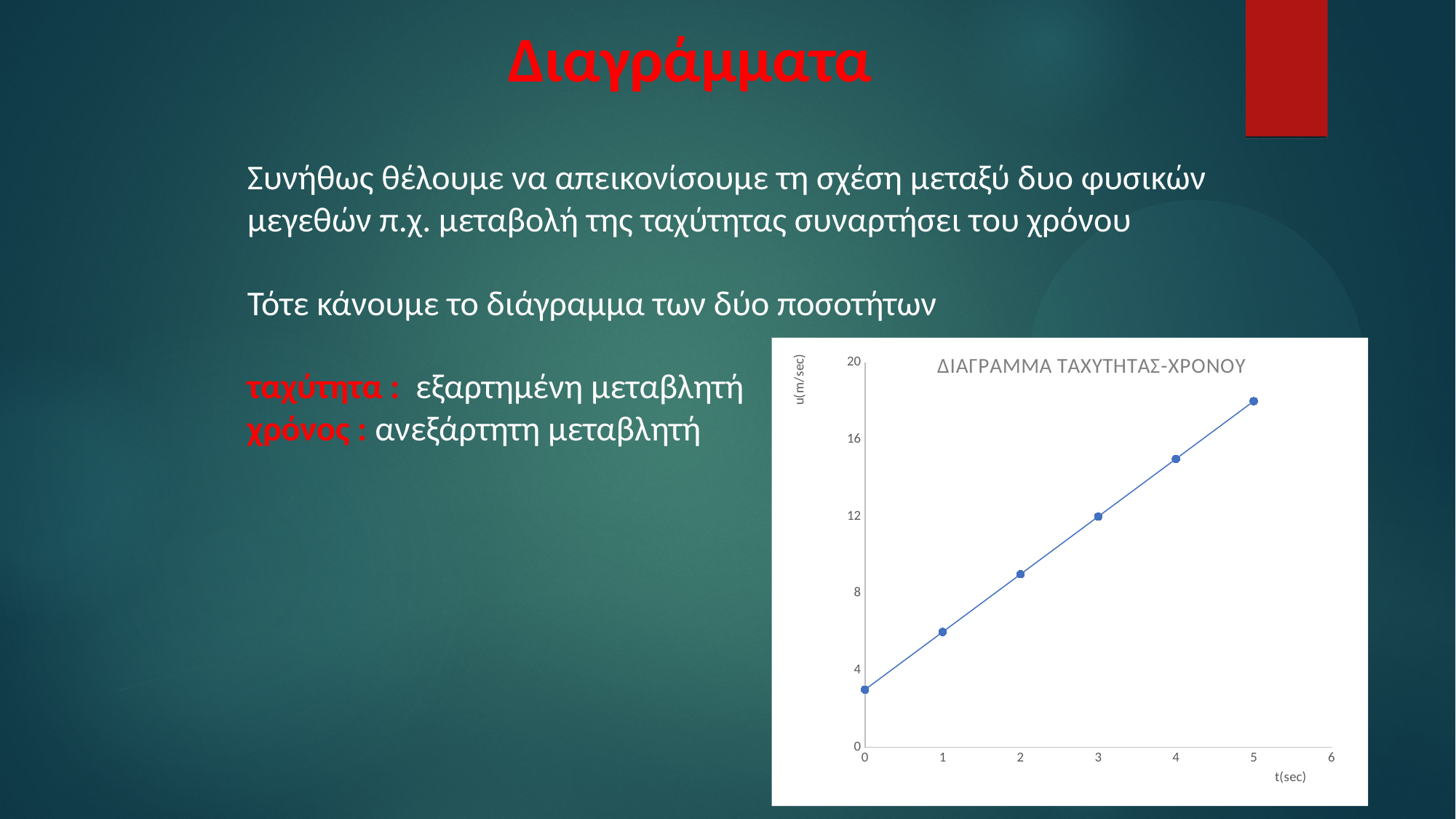
What is the title of the chart? ΔΙΑΓΡΑΜΜΑ ΤΑΧΥΤΗΤΑΣ-ΧΡΟΝΟΥ What is the value of u(m/sec) at t = 3 sec? 12 What kind of chart is shown on the slide? line chart Is the value of u(m/sec) at t = 0 sec greater or less than 4? less Which is larger, the value of u(m/sec) at t = 4 sec or at t = 2 sec? t = 4 sec How many data points are plotted on the chart? 6 At which value of t(sec) is u(m/sec) lowest? 0 Do the values rise or fall as t(sec) increases? rise What is the label of the vertical axis of the chart? u(m/sec) At which value of t(sec) is u(m/sec) highest? 5 Is the value of u(m/sec) at t = 5 sec greater or less than 16? greater Is the value of u(m/sec) at t = 4 sec greater or less than 16? less